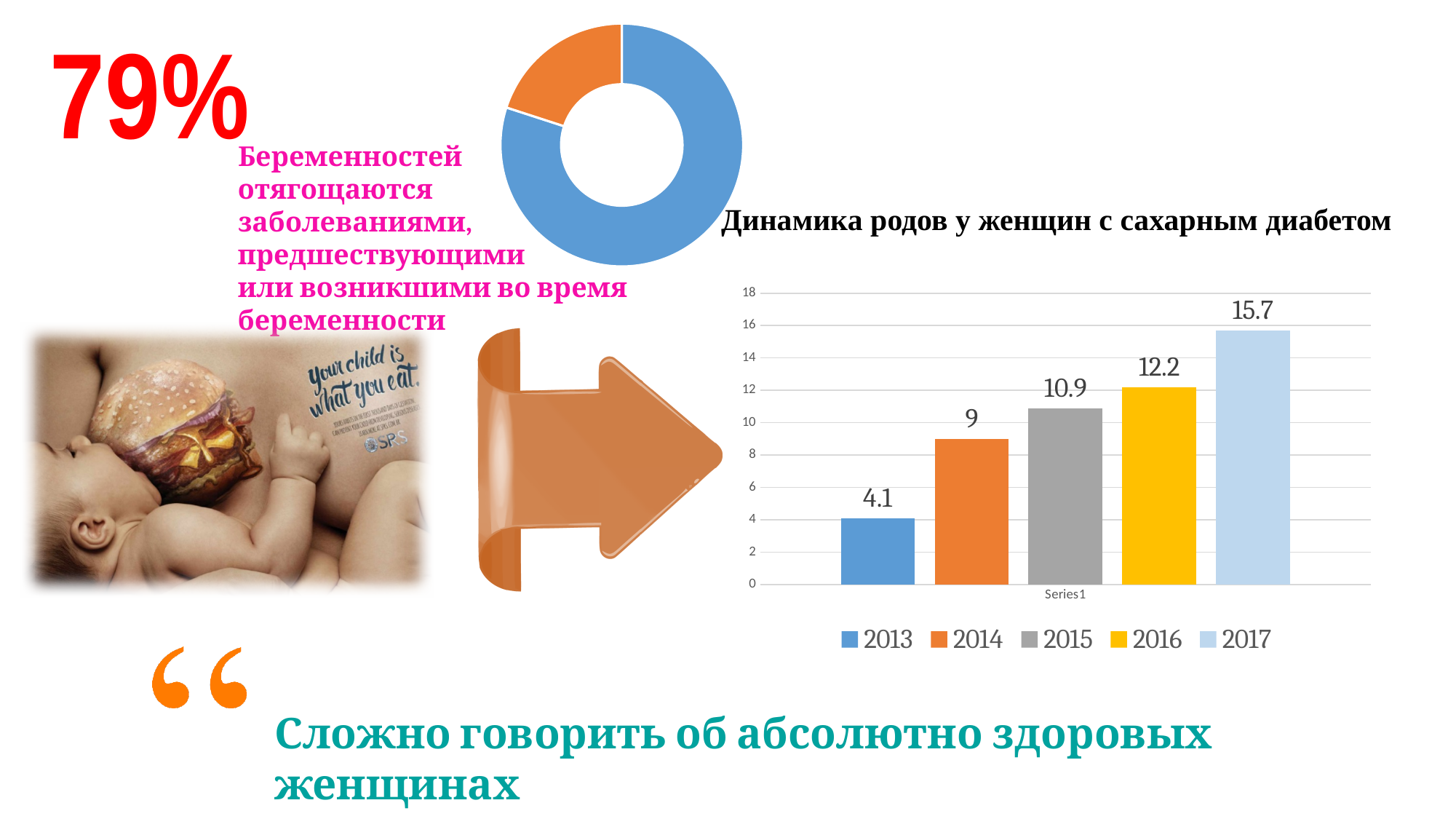
In the bar chart titled 'Динамика родов у женщин с сахарным диабетом', what is the value for 2017? 15.7 In the bar chart titled 'Динамика родов у женщин с сахарным диабетом', which year has the highest value? 2017 In the bar chart titled 'Динамика родов у женщин с сахарным диабетом', what is the value for 2015? 10.9 How many bars are shown in the bar chart titled 'Динамика родов у женщин с сахарным диабетом'? 5 In the bar chart titled 'Динамика родов у женщин с сахарным диабетом', what is the difference between the values for 2017 and 2013? 11.6 In the bar chart titled 'Динамика родов у женщин с сахарным диабетом', what is the value for 2013? 4.1 In the bar chart titled 'Динамика родов у женщин с сахарным диабетом', which year has the lowest value? 2013 How many entries does the legend of the bar chart titled 'Динамика родов у женщин с сахарным диабетом' list? 5 In the bar chart titled 'Динамика родов у женщин с сахарным диабетом', is the value for 2015 greater or less than 10? greater In the bar chart titled 'Динамика родов у женщин с сахарным диабетом', which is larger, the value for 2014 or the value for 2016? 2016 What kind of chart is shown at the top centre of the slide, next to the '79%' text? doughnut chart In the bar chart titled 'Динамика родов у женщин с сахарным диабетом', do the values rise or fall from 2013 to 2017? rise